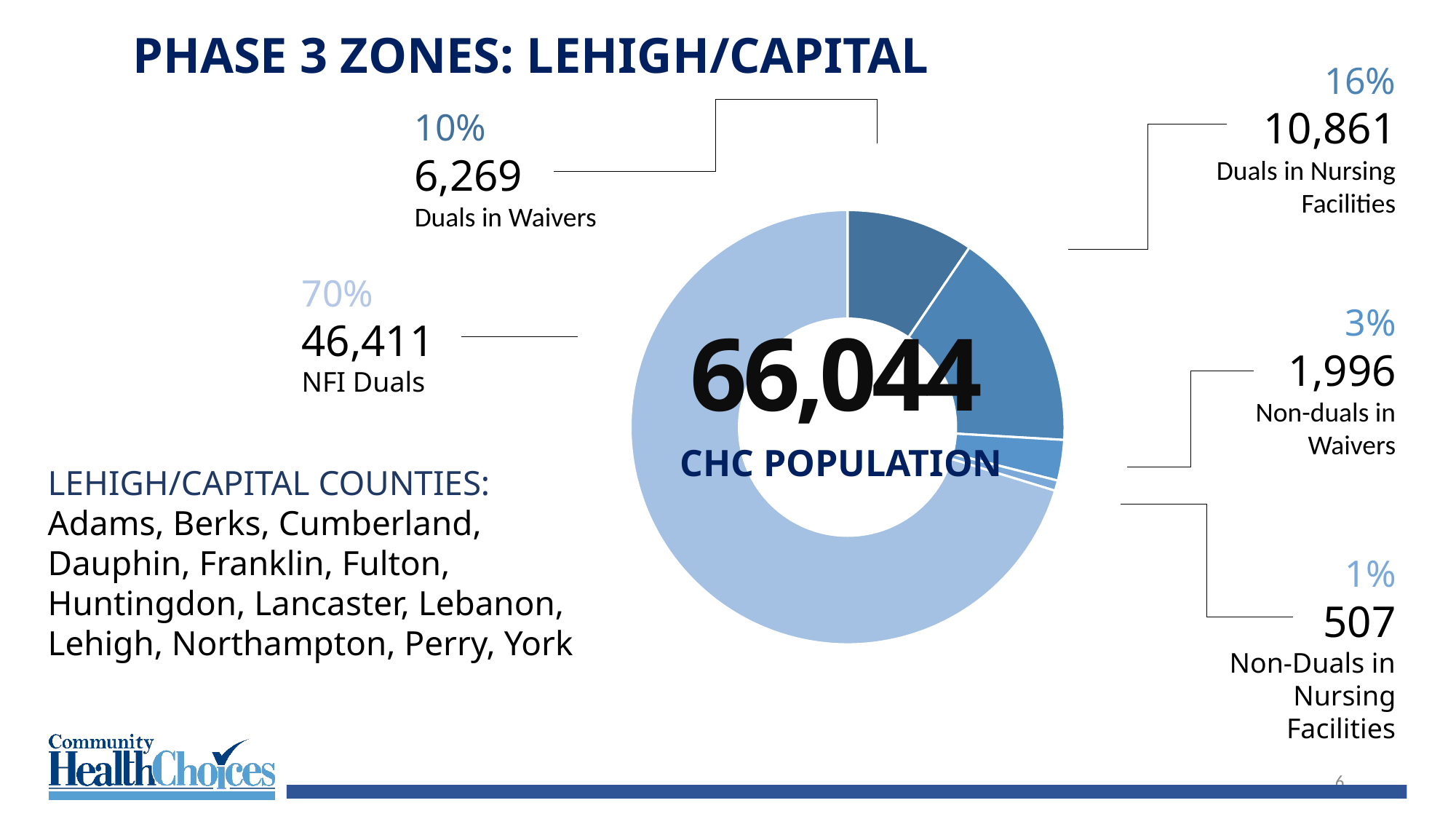
What is the total CHC population shown in the centre of the chart? 66,044 How many NFI Duals are shown on the chart? 46,411 How many Non-duals in Waivers are shown? 1,996 How many categories are shown in the chart? 5 What percentage of the chart is Duals in Waivers? 10% Which is larger, Non-duals in Waivers or Non-Duals in Nursing Facilities? Non-duals in Waivers What kind of chart is shown on the slide? Pie chart (donut) Which category has the smallest slice of the chart? Non-Duals in Nursing Facilities How many Duals in Nursing Facilities are shown? 10,861 What share of the CHC population are NFI Duals? 70% What is the difference between the number of Duals in Nursing Facilities and Duals in Waivers? 4,592 Which category has the largest slice of the chart? NFI Duals